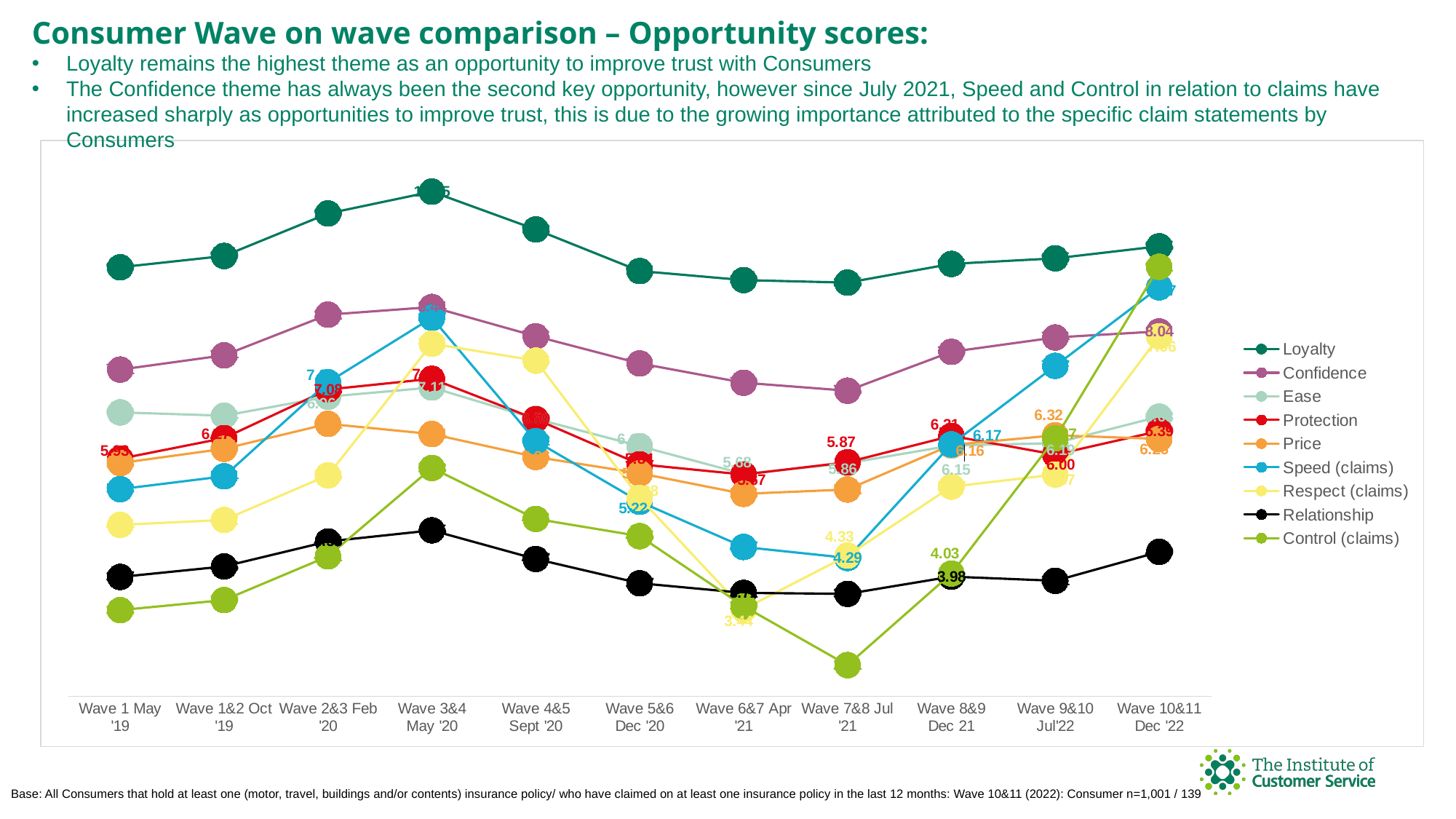
What type of chart is shown on the slide? line chart What is the Speed (claims) score at Wave 7&8 Jul '21? 4.29 Does the Loyalty line rise or fall from Wave 1 May '19 to Wave 3&4 May '20? rise How many series does the legend list? 9 Which series has the highest score at Wave 10&11 Dec '22? Loyalty What is the Protection score at Wave 7&8 Jul '21? 5.87 How many waves (x-axis categories) are plotted on the chart? 11 What is the Confidence score at Wave 10&11 Dec '22? 8.04 What is the difference between the Control (claims) score (4.03) and the Relationship score (3.98) at Wave 8&9 Dec 21? 0.05 Which series has the lowest score at Wave 7&8 Jul '21? Control (claims)